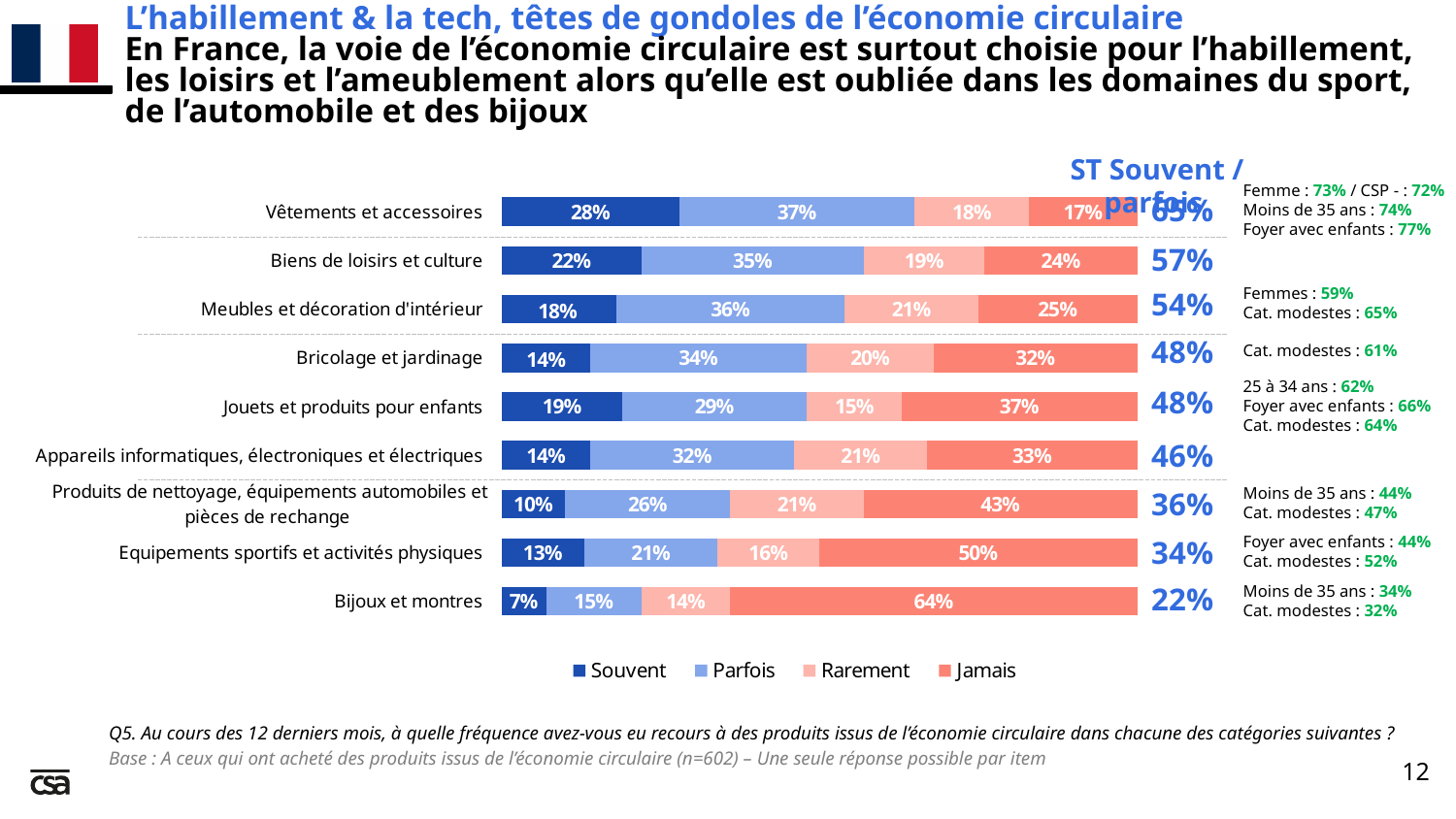
Which category has the lowest 'Souvent' value? Bijoux et montres Which category has the highest 'Jamais' value? Bijoux et montres What kind of chart is shown on the slide? Stacked bar chart What is the 'Parfois' value for 'Meubles et décoration d'intérieur'? 36% Which is larger: the 'Souvent' value for 'Jouets et produits pour enfants' or for 'Bricolage et jardinage'? Jouets et produits pour enfants How many product categories are plotted in the chart? 9 What is the difference between the 'Jamais' values for 'Bijoux et montres' and 'Vêtements et accessoires'? 47% What is the 'Jamais' value for 'Bijoux et montres'? 64% What is the 'Rarement' value for 'Equipements sportifs et activités physiques'? 16% How many series does the legend list? 4 What is the 'Souvent' value for 'Vêtements et accessoires'? 28% What is the 'ST Souvent / parfois' value shown for 'Biens de loisirs et culture'? 57%